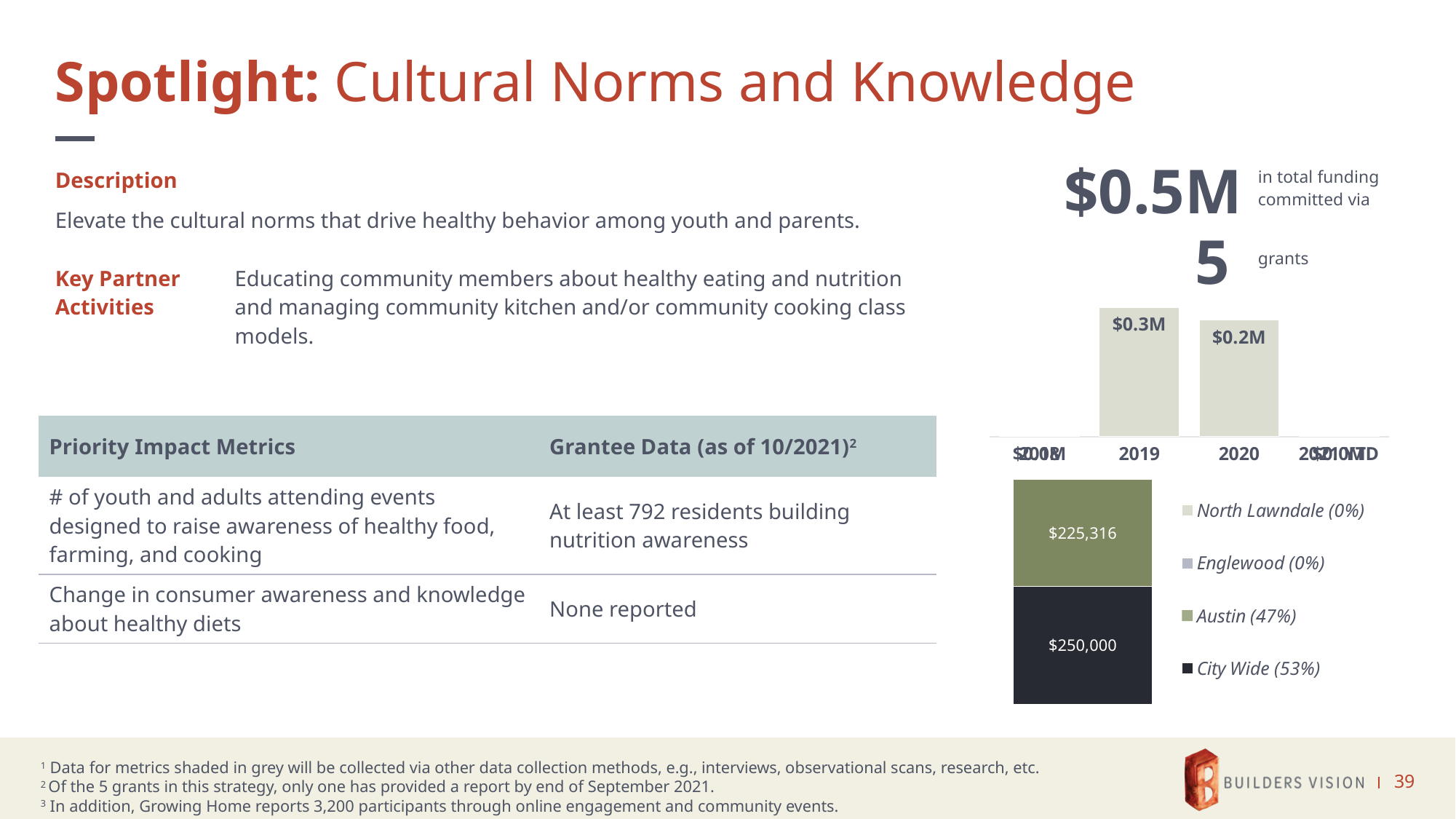
In the bar chart of funding by year, what is the value for 2019? $0.3M In the stacked bar chart at the bottom right, which segment is larger, City Wide or Austin? City Wide In the stacked bar chart at the bottom right, what is the difference between the City Wide and Austin values? $24,684 In the stacked bar chart at the bottom right, what is the value for Austin? $225,316 In the bar chart of funding by year, which year has the highest bar? 2019 In the stacked bar chart at the bottom right, what is the value for City Wide? $250,000 In the bar chart of funding by year, what is the difference between the 2019 and 2020 values? $0.1M How many series does the legend of the stacked bar chart at the bottom right list? 4 What kind of chart is the funding-by-year chart on the right of the slide? bar chart In the bar chart of funding by year, what is the value for 2020? $0.2M In the stacked bar chart at the bottom right, what is the total of the City Wide and Austin segments? $475,316 In the bar chart of funding by year, which is larger, the value for 2019 or the value for 2020? 2019